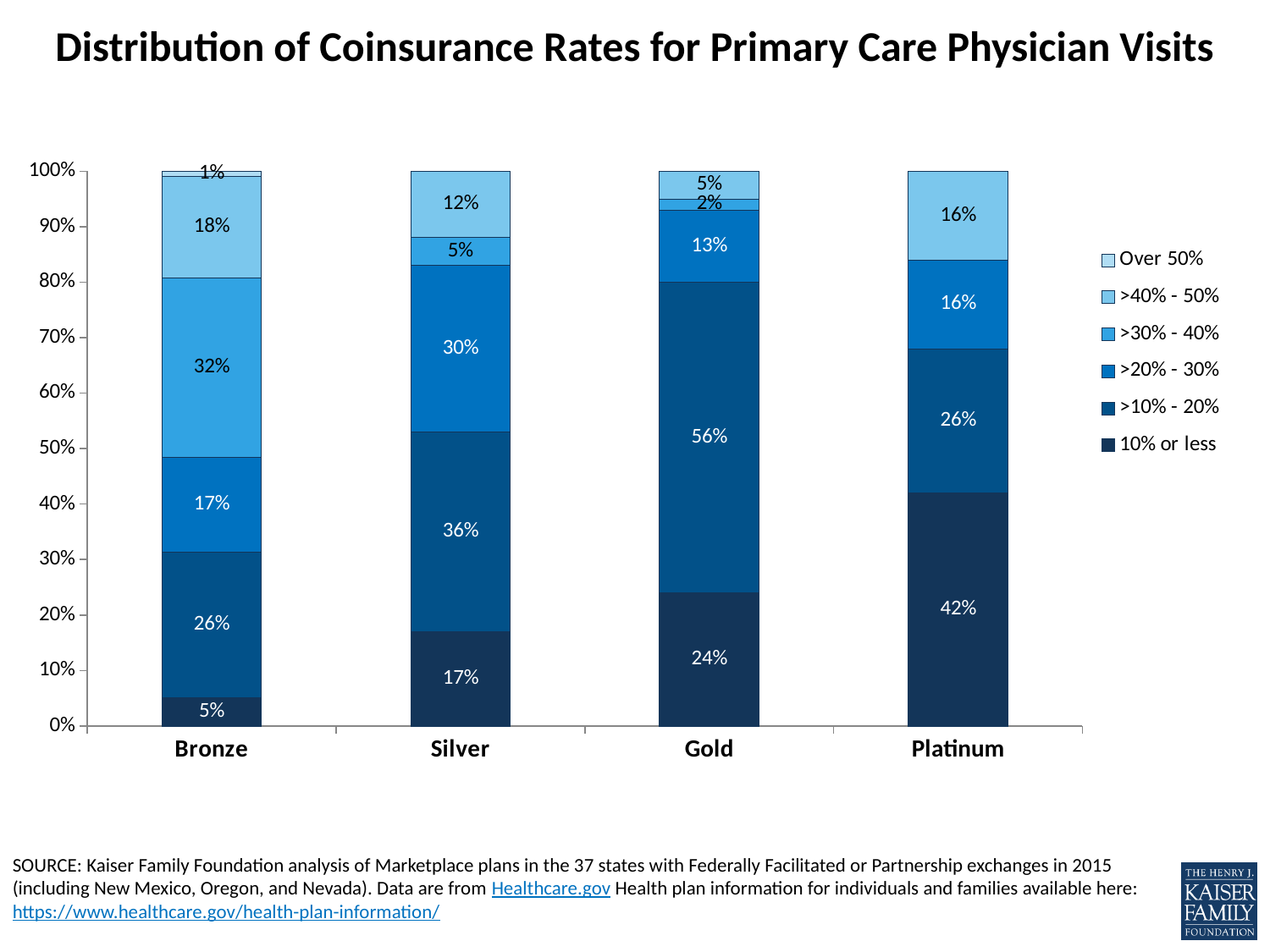
How many percentage points larger is the 10% or less share for Platinum than for Gold? 18 percentage points How many series does the legend list? 6 Which plan type has the largest share of plans with coinsurance of 10% or less? Platinum What share of Bronze plans have a coinsurance rate of 10% or less? 5% What share of Platinum plans have a coinsurance rate of 10% or less? 42% What kind of chart is shown on the slide? Stacked bar chart How many plan categories are shown on the x axis? 4 What is the title of the chart? Distribution of Coinsurance Rates for Primary Care Physician Visits Which plan type has the smallest share of plans with coinsurance of 10% or less? Bronze Which has a larger share in the >10% - 20% range, Silver or Bronze? Silver What share of Silver plans fall in the >40% - 50% coinsurance range? 12% What share of Gold plans fall in the >10% - 20% coinsurance range? 56%